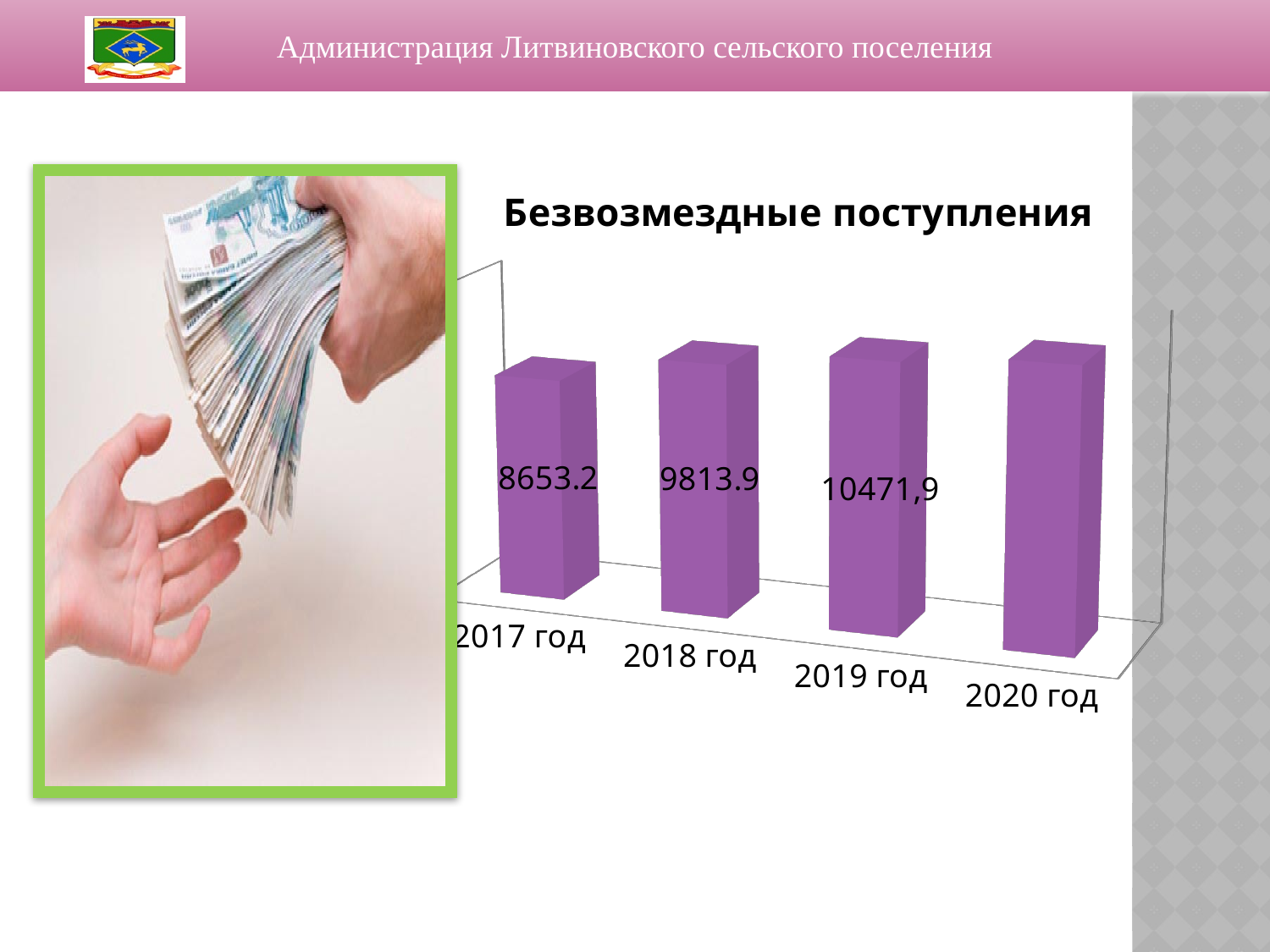
Do the labelled values rise or fall from 2017 год to 2019 год? rise Among the labelled years 2017, 2018 and 2019, which has the lowest value? 2017 год What is the value shown for 2018 год? 9813.9 What kind of chart is shown on the slide? bar chart Which is larger, the value for 2017 год or the value for 2018 год? 2018 год What is the title of the chart? Безвозмездные поступления What is the value shown for 2019 год? 10471,9 How many years (categories) are shown on the chart? 4 What is the value shown for 2017 год? 8653.2 Among the labelled years 2017, 2018 and 2019, which has the highest value? 2019 год What is the difference between the values for 2018 год and 2017 год? 1160.7 Which is larger, the value for 2018 год or the value for 2019 год? 2019 год